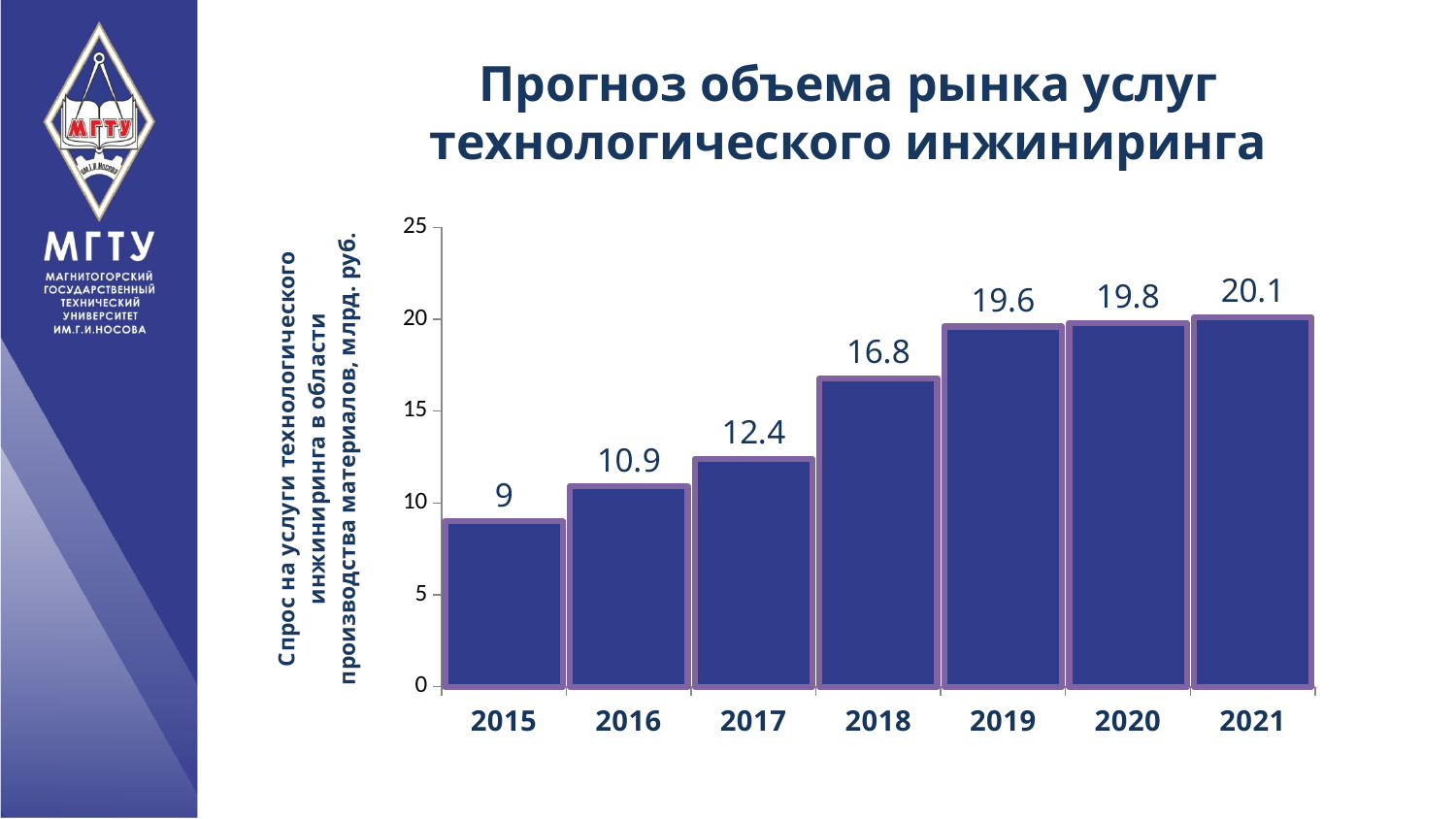
What is the difference between the values for 2021 and 2015? 11.1 What is the difference between the values for 2018 and 2016? 5.9 What is the value for 2015? 9 What is the value for 2019? 19.6 What is the value for 2017? 12.4 How many years are shown on the x axis? 7 Is the value for 2020 greater or less than 15? greater What kind of chart is shown on the slide? bar chart Which year has the highest value? 2021 Which is larger, the value for 2017 or the value for 2018? 2018 Which year has the lowest value? 2015 Do the values rise or fall from 2015 to 2021? rise